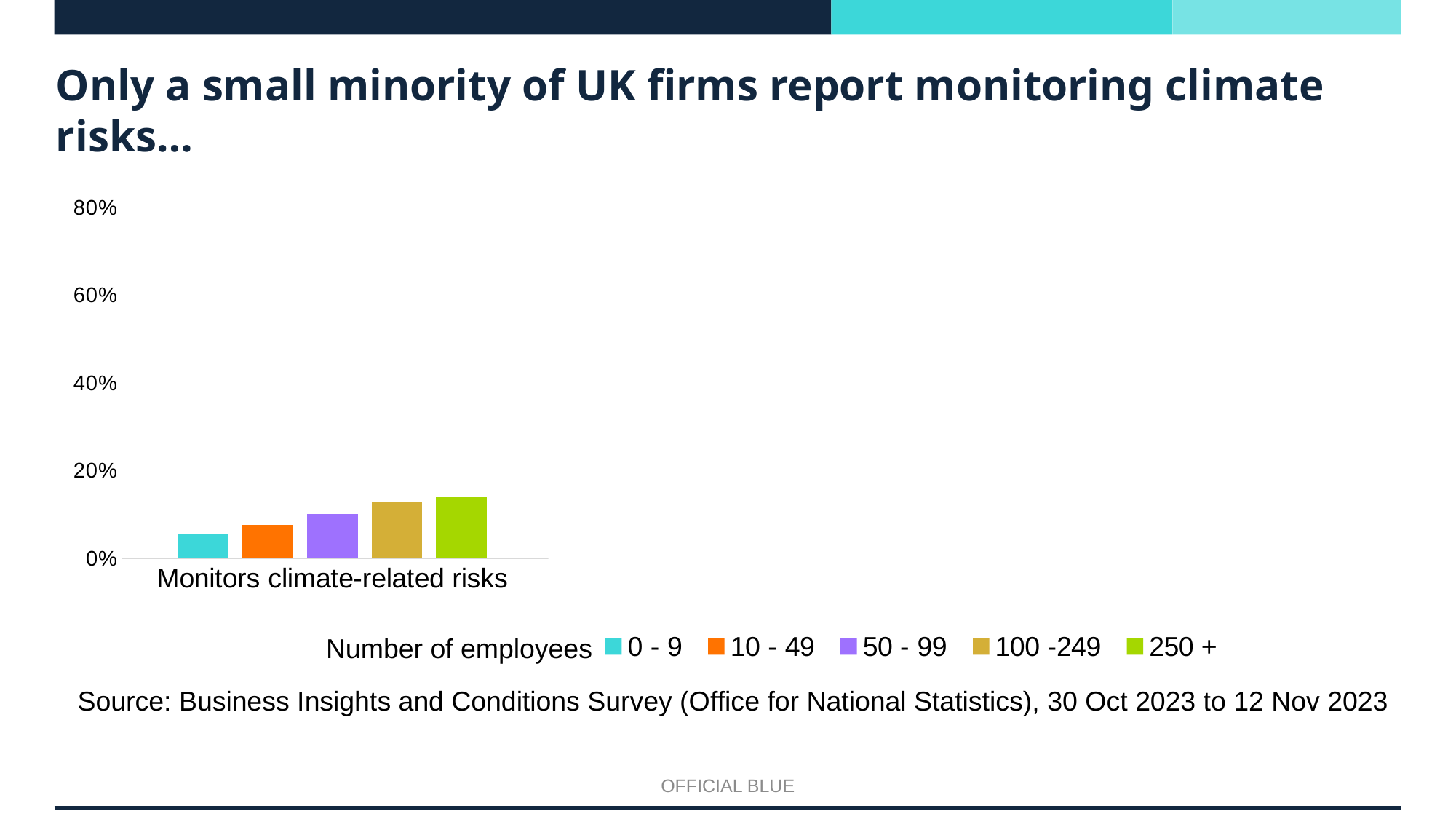
Do the bars rise or fall as the number of employees increases from 0 - 9 to 250 +? rise Is the value for firms with 100 -249 employees greater or less than 40%? less What is the title of the legend? Number of employees What is the label of the category on the x axis? Monitors climate-related risks Which employee-size group has the lowest share of firms monitoring climate-related risks? 0 - 9 Which is larger: the value for firms with 10 - 49 employees or firms with 250 + employees? 250 + How many series does the legend list? 5 Is the value for firms with 250 + employees greater or less than 20%? less Which is larger: the value for firms with 0 - 9 employees or firms with 50 - 99 employees? 50 - 99 What kind of chart is shown on the slide? bar chart How many categories are shown on the x axis? 1 Is the value for firms with 0 - 9 employees greater or less than 20%? less